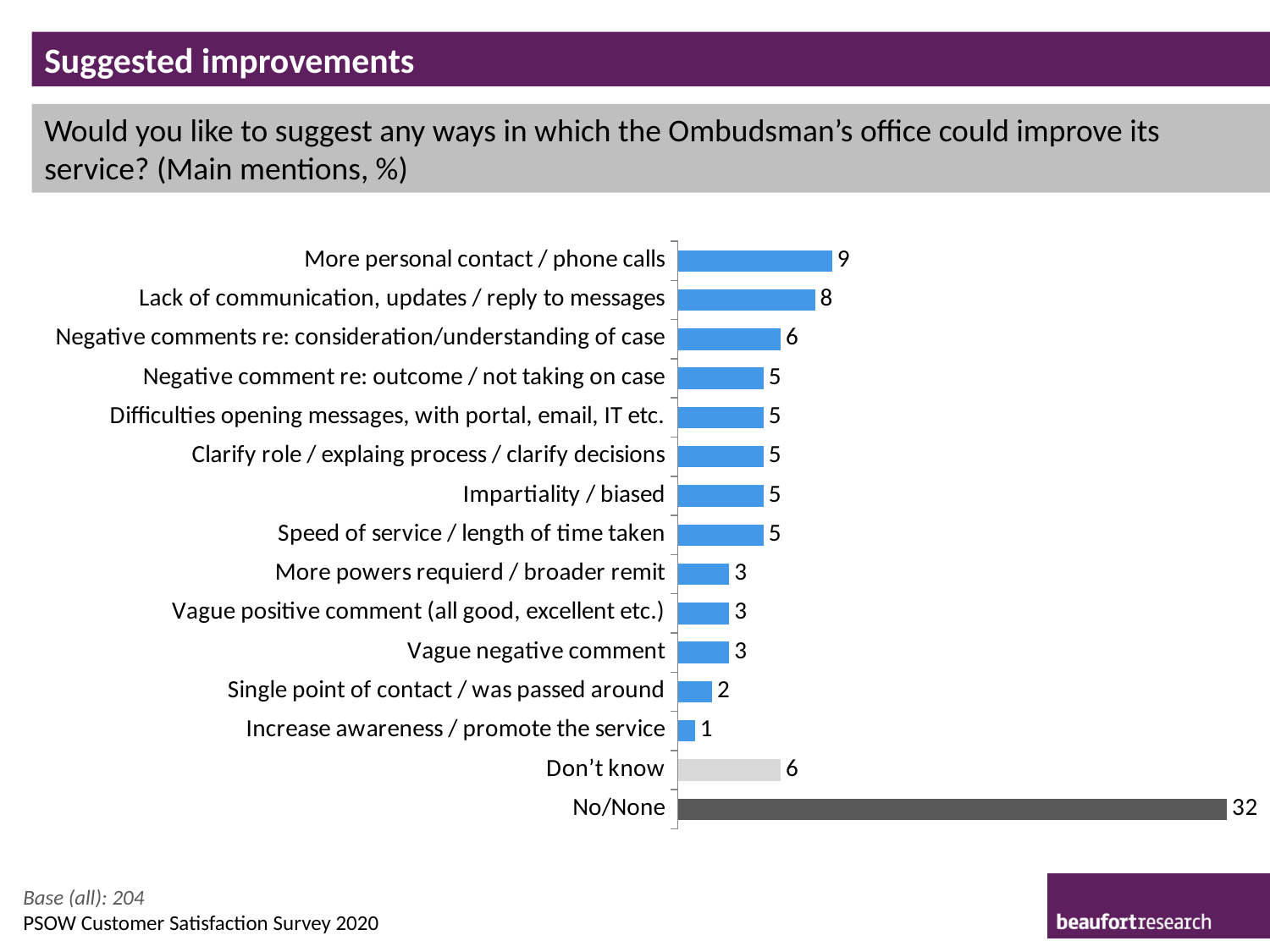
Which is larger: "Lack of communication, updates / reply to messages" or "Negative comments re: consideration/understanding of case"? Lack of communication, updates / reply to messages What is the value for "More personal contact / phone calls"? 9 Which category has the lowest value? Increase awareness / promote the service How many categories are shown in the chart? 15 What is the value for "Increase awareness / promote the service"? 1 What is the value for "Don't know"? 6 Which category has the highest value? No/None What is the value for "No/None"? 32 What kind of chart is shown on the slide? Bar chart What is the difference between "Single point of contact / was passed around" and "Vague negative comment"? 1 What is the base (number of respondents) stated on the slide? 204 What is the difference between "No/None" and "More personal contact / phone calls"? 23